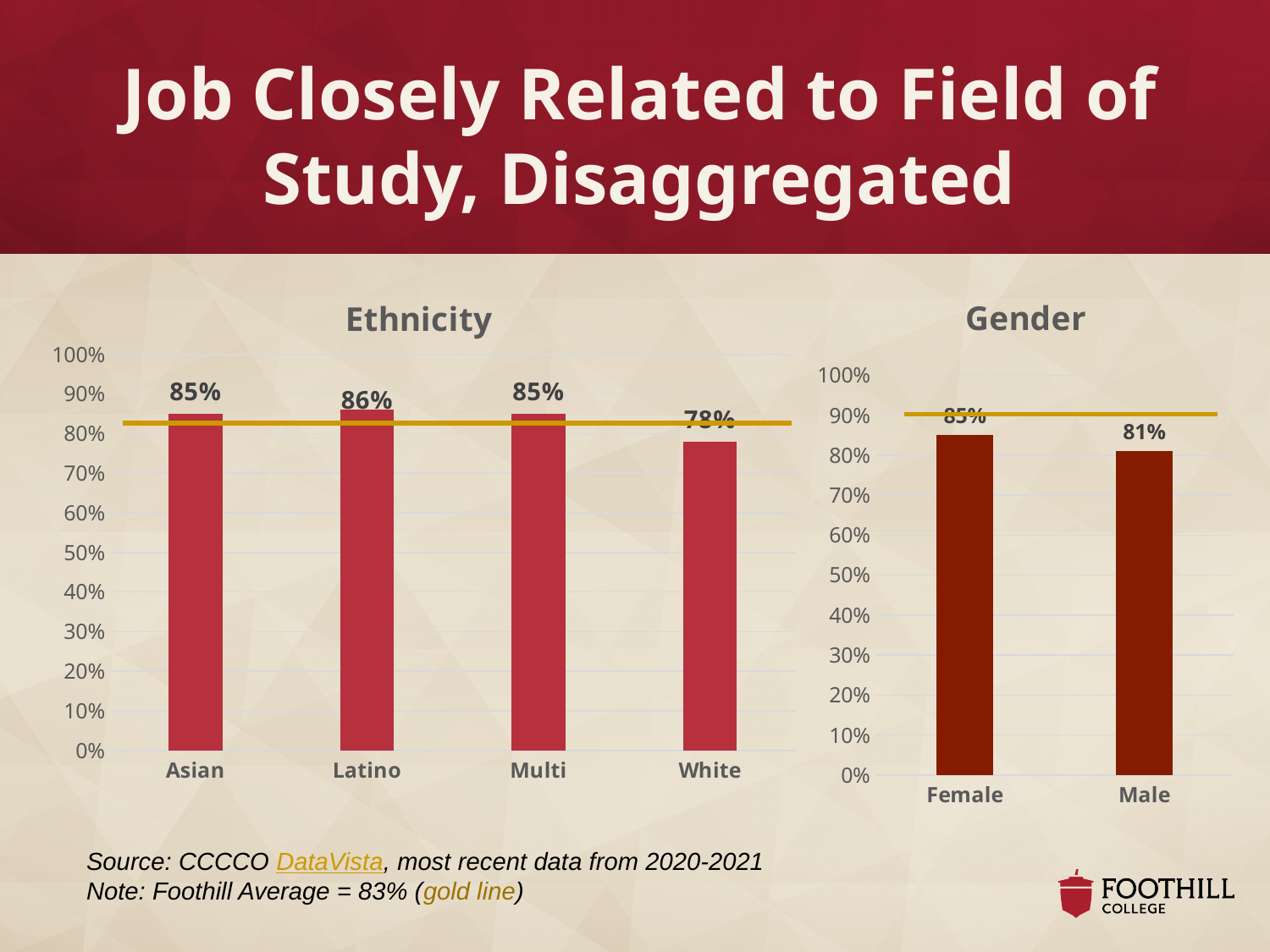
In the Ethnicity chart, how many categories are shown? 4 What kind of chart is the Ethnicity chart? Bar chart In the Ethnicity chart, what is the value for Asian? 85% In the Gender chart, which category has the higher value, Female or Male? Female In the Ethnicity chart, what is the value for Latino? 86% In the Ethnicity chart, which category has the lowest value? White In the Ethnicity chart, what is the difference between the values for Latino and Asian? 1% In the Gender chart, how many categories are shown? 2 In the Gender chart, what is the value for Male? 81% In the Ethnicity chart, is the value for White greater or less than 80%? less In the Gender chart, is the value for Female greater or less than 80%? greater According to the note on the slide, what value does the gold line represent? Foothill Average = 83%